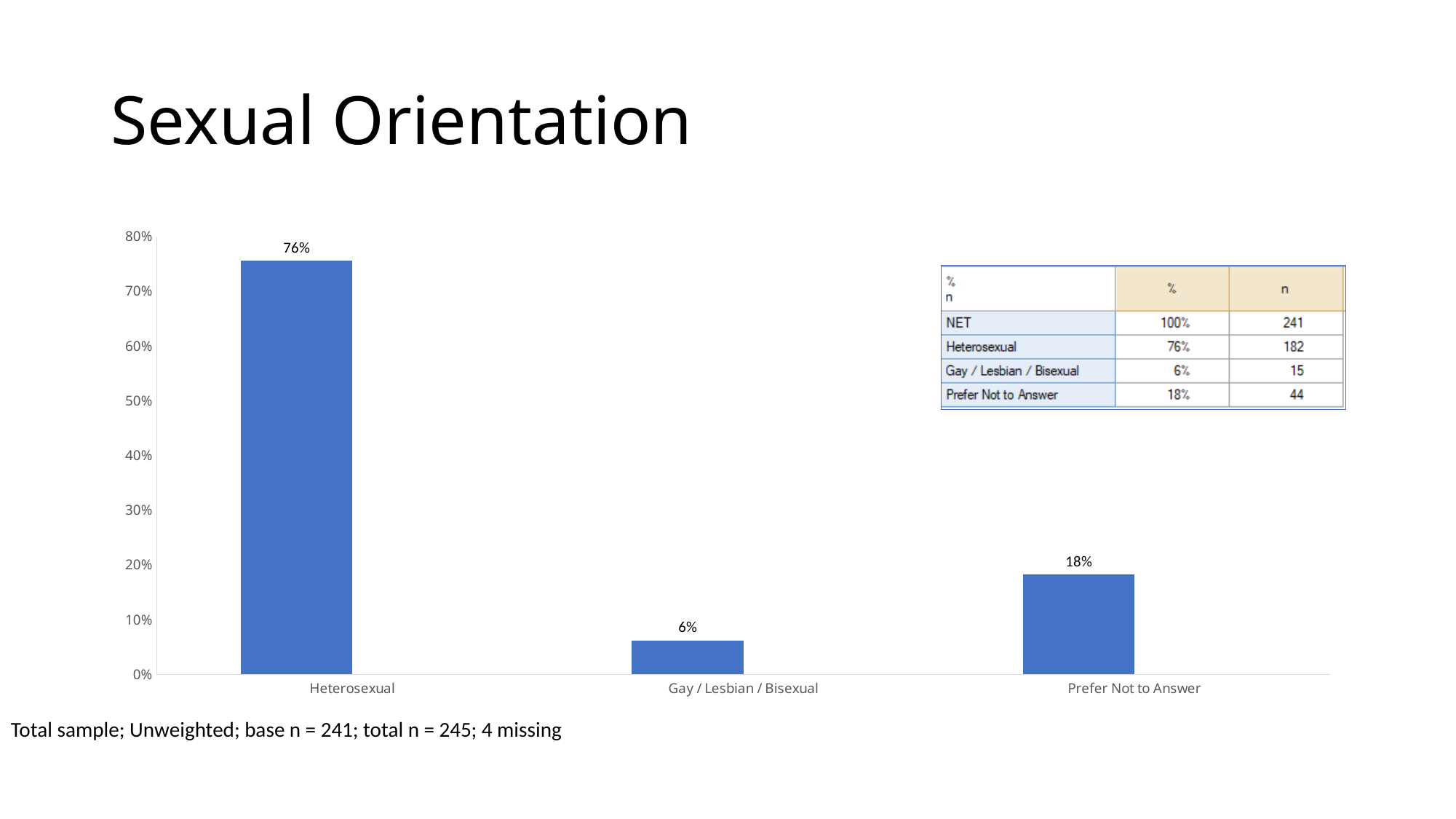
Which is larger, the value for Prefer Not to Answer or the value for Gay / Lesbian / Bisexual? Prefer Not to Answer What is the value for Prefer Not to Answer? 18% What is the value for Gay / Lesbian / Bisexual? 6% What is the difference between the values for Prefer Not to Answer and Gay / Lesbian / Bisexual? 12% Is the value for Prefer Not to Answer greater or less than 20%? less What is the value for Heterosexual? 76% What is the title of the slide containing the chart? Sexual Orientation What is the difference between the values for Heterosexual and Prefer Not to Answer? 58% How many categories are shown on the x axis of the chart? 3 Which category has the highest value? Heterosexual What kind of chart is shown on the slide? bar chart Which category has the lowest value? Gay / Lesbian / Bisexual